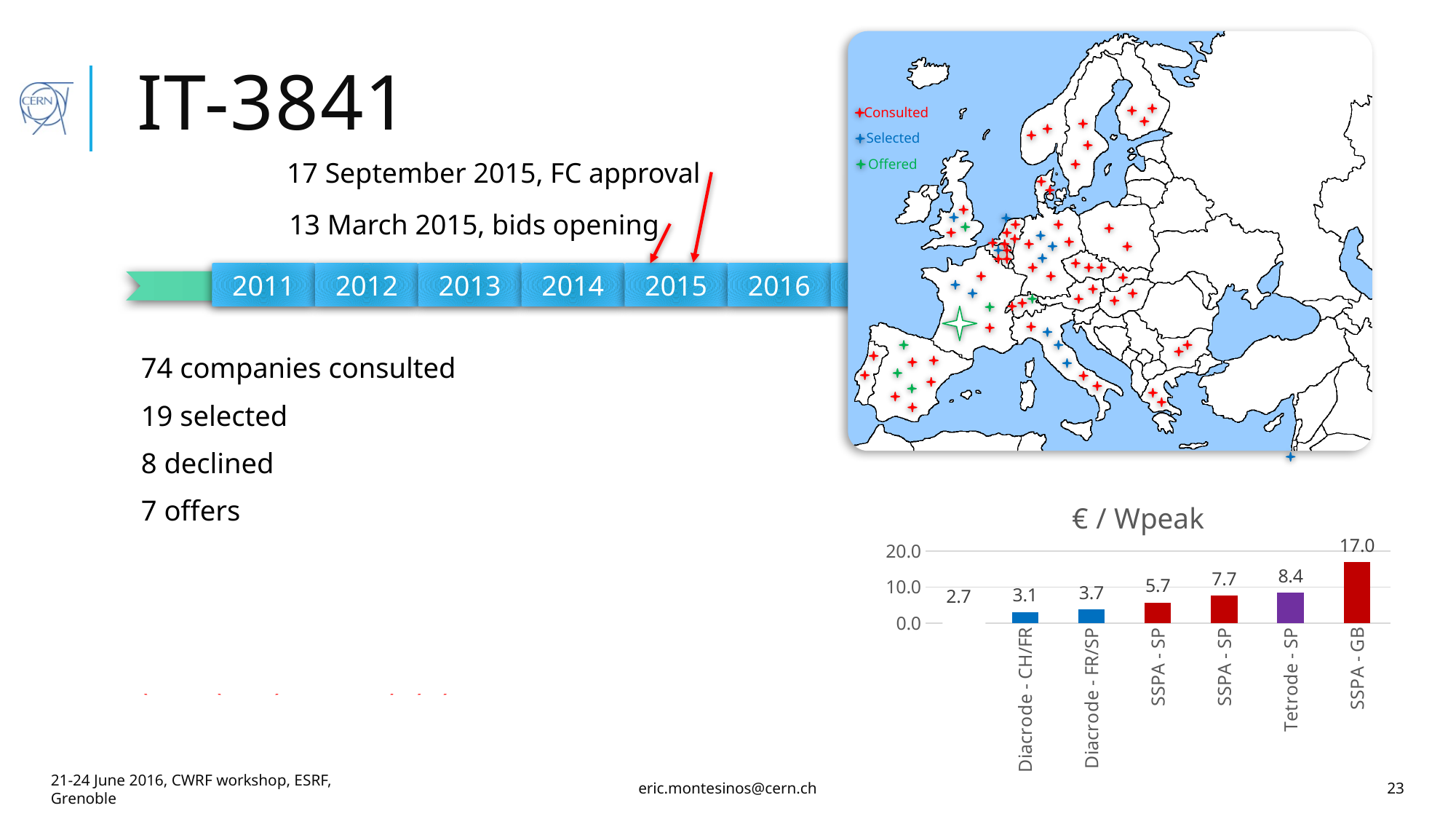
In the € / Wpeak chart, what is the value for Diacrode - CH/FR? 3.1 In the € / Wpeak chart, what is the value for Tetrode - SP? 8.4 What kind of chart is the € / Wpeak chart? bar chart In the € / Wpeak chart, which is larger: the value for Diacrode - FR/SP or for Tetrode - SP? Tetrode - SP In the € / Wpeak chart, what is the value for SSPA - GB? 17.0 In the € / Wpeak chart, what is the value for Diacrode - FR/SP? 3.7 In the € / Wpeak chart, is the value for SSPA - GB greater or less than 10.0? greater In the € / Wpeak chart, what is the difference between the values for SSPA - GB and Tetrode - SP? 8.6 In the € / Wpeak chart, what is the smallest data label value printed? 2.7 In the € / Wpeak chart, what is the difference between the values for Diacrode - FR/SP and Diacrode - CH/FR? 0.6 In the € / Wpeak chart, which category has the highest value? SSPA - GB In the € / Wpeak chart, do the values rise or fall from left to right along the x axis? rise